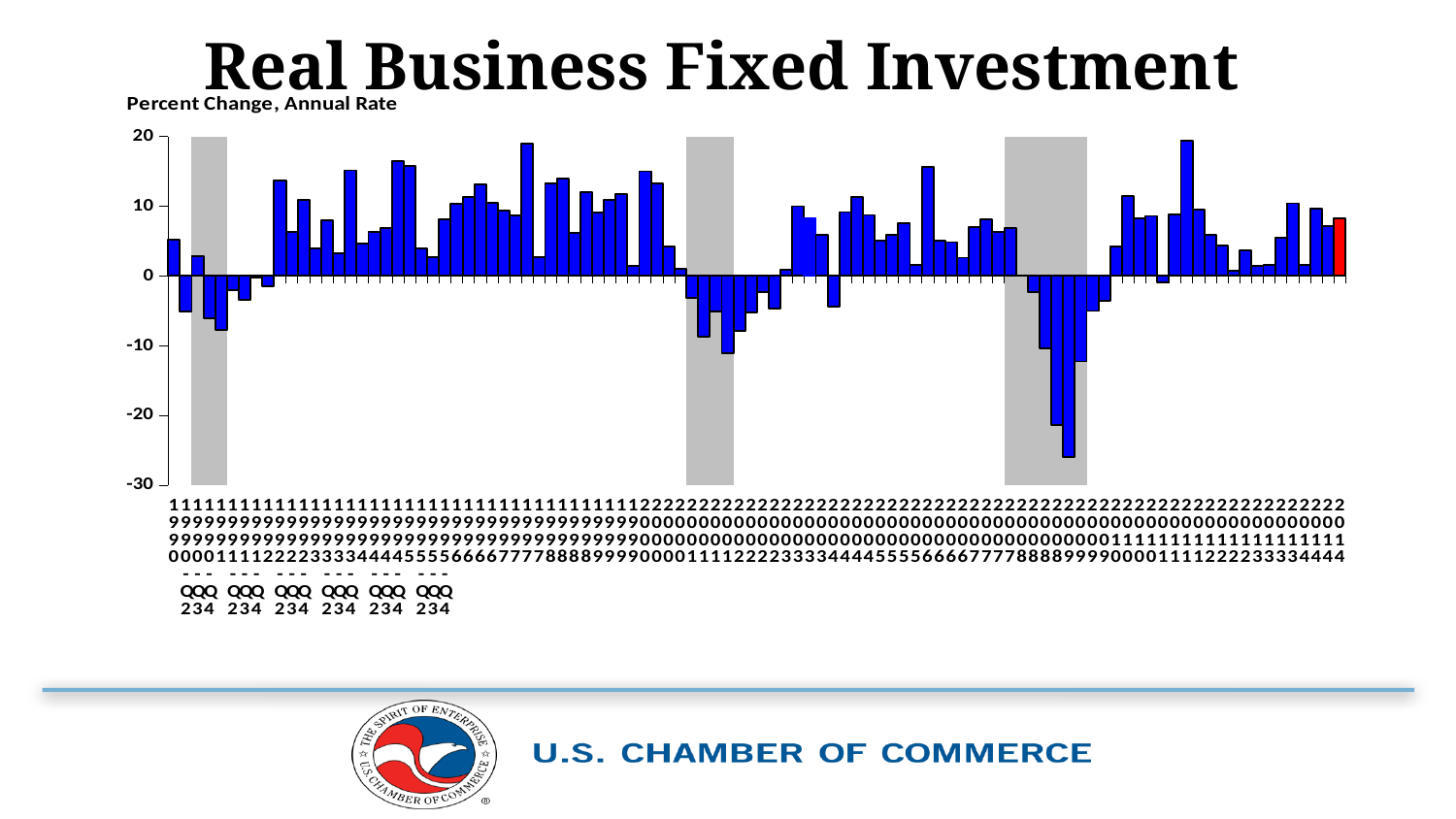
Is the value for the tallest bar in the chart greater or less than 10? greater What colour is the last (most recent) bar in the chart? red Is the value for the lowest bar in the chart greater or less than -20? less Is the value for the red bar at the right end of the chart greater or less than 0? greater What is the title of the chart? Real Business Fixed Investment What kind of chart is shown on the slide? bar chart